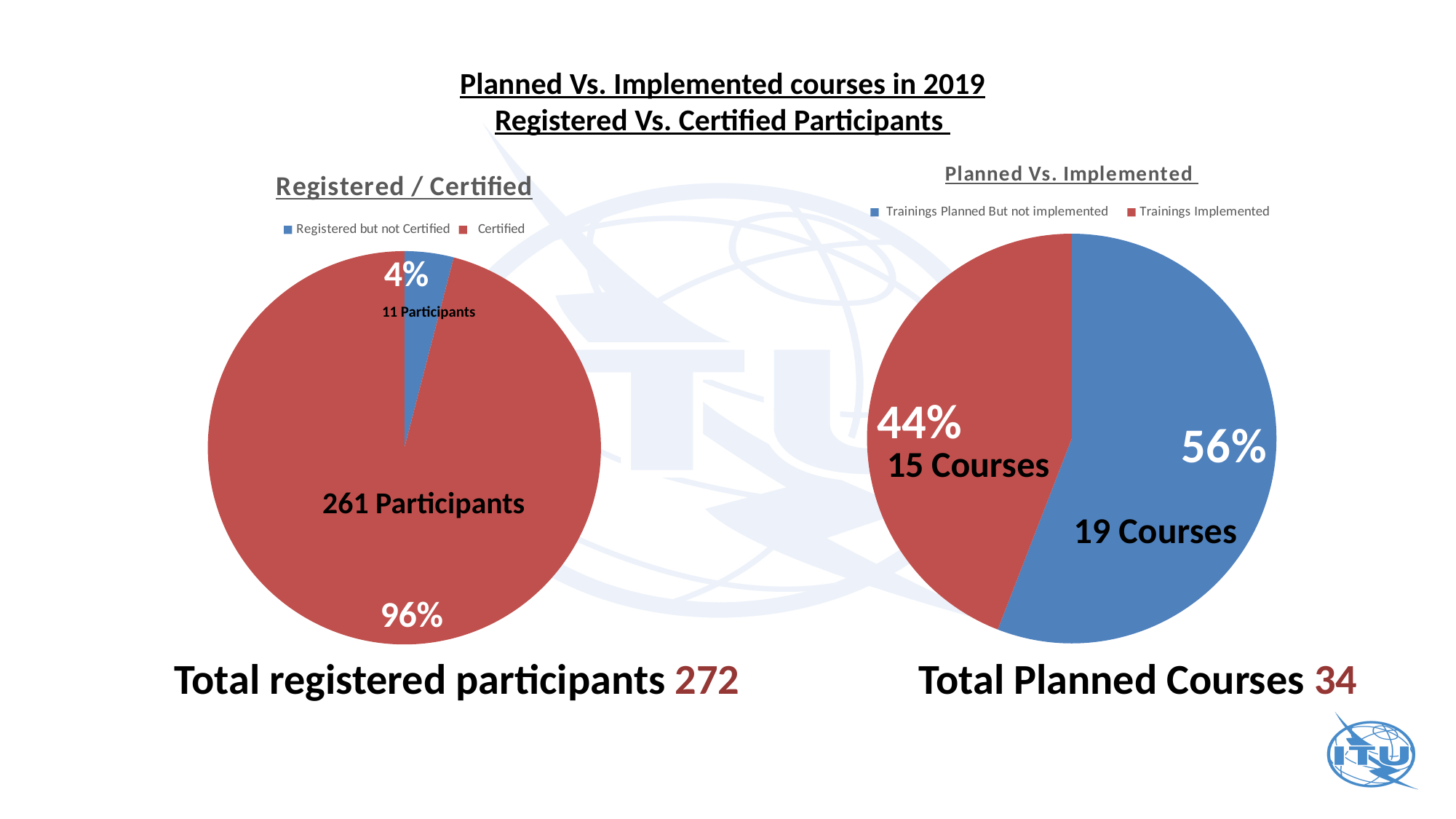
In the "Registered / Certified" chart, what is the difference between the number of Certified participants and the number Registered but not Certified? 250 In the "Registered / Certified" chart, how many participants are Registered but not Certified? 11 Participants In the "Planned Vs. Implemented" chart, what is the difference in courses between Trainings Planned But not implemented and Trainings Implemented? 4 In the "Registered / Certified" chart, which slice is the smallest? Registered but not Certified In the "Planned Vs. Implemented" chart, what share of the pie is Trainings Planned But not implemented? 56% What type of chart is the "Registered / Certified" chart? pie chart In the "Planned Vs. Implemented" chart, how many courses were Trainings Implemented? 15 Courses In the "Registered / Certified" chart, what share of the pie is Certified? 96% How many series does the legend of the "Planned Vs. Implemented" chart list? 2 How many slices does the "Planned Vs. Implemented" pie chart have? 2 In the "Planned Vs. Implemented" chart, which is larger: Trainings Planned But not implemented or Trainings Implemented? Trainings Planned But not implemented In the "Registered / Certified" chart, how many participants are Certified? 261 Participants